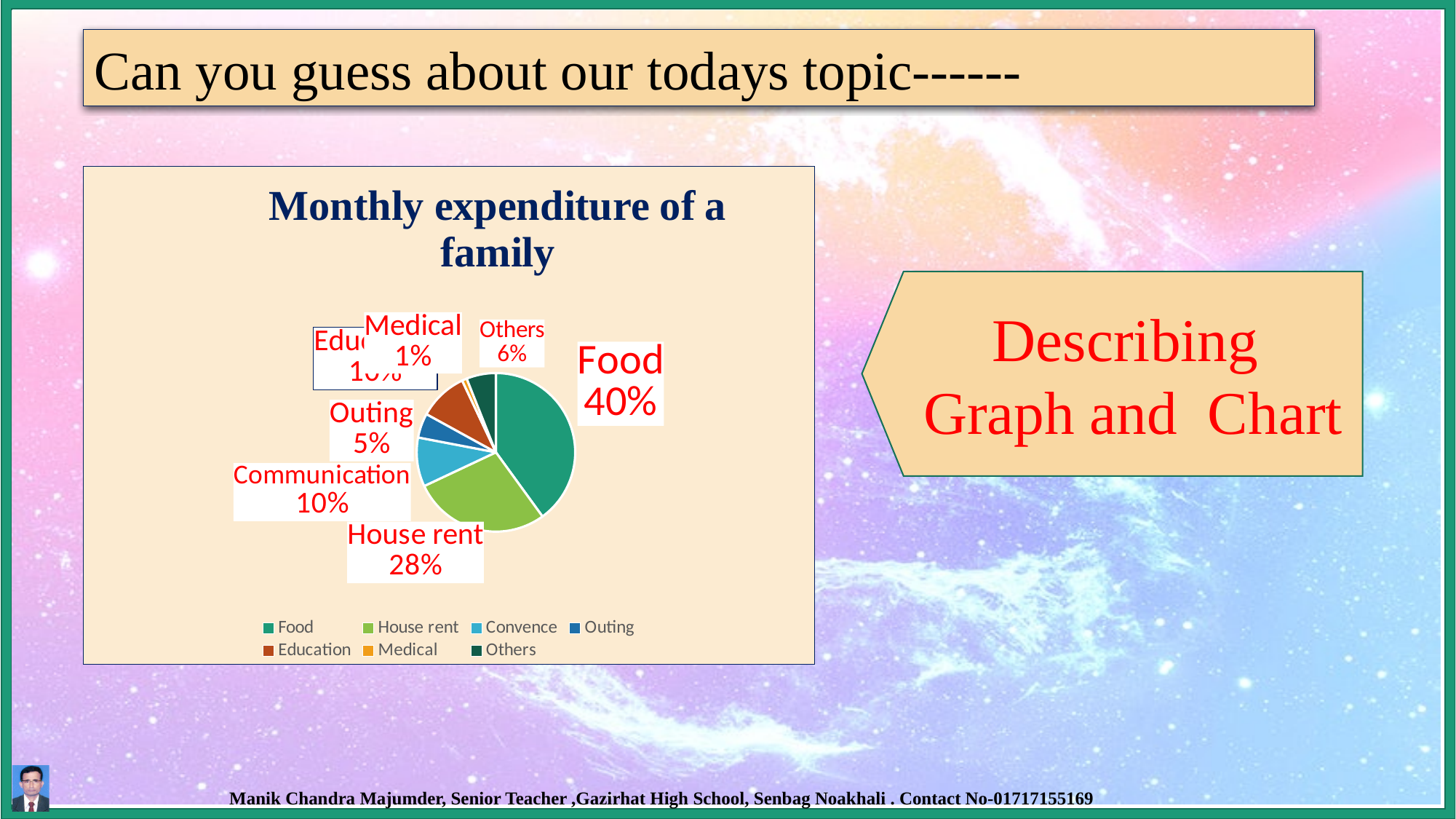
How many percentage points larger is the Food share than the House rent share? 12% What percentage is labelled for Medical? 1% What percentage is labelled for Communication? 10% Which category has the largest share of the pie? Food Which category has the smallest share of the pie? Medical What percentage is labelled for Others? 6% What percentage is labelled for Outing? 5% What is the title of the chart? Monthly expenditure of a family What percentage of the monthly expenditure goes to House rent? 28% What kind of chart is shown on the slide? pie chart How many categories does the legend list? 7 What percentage of the monthly expenditure goes to Food? 40%